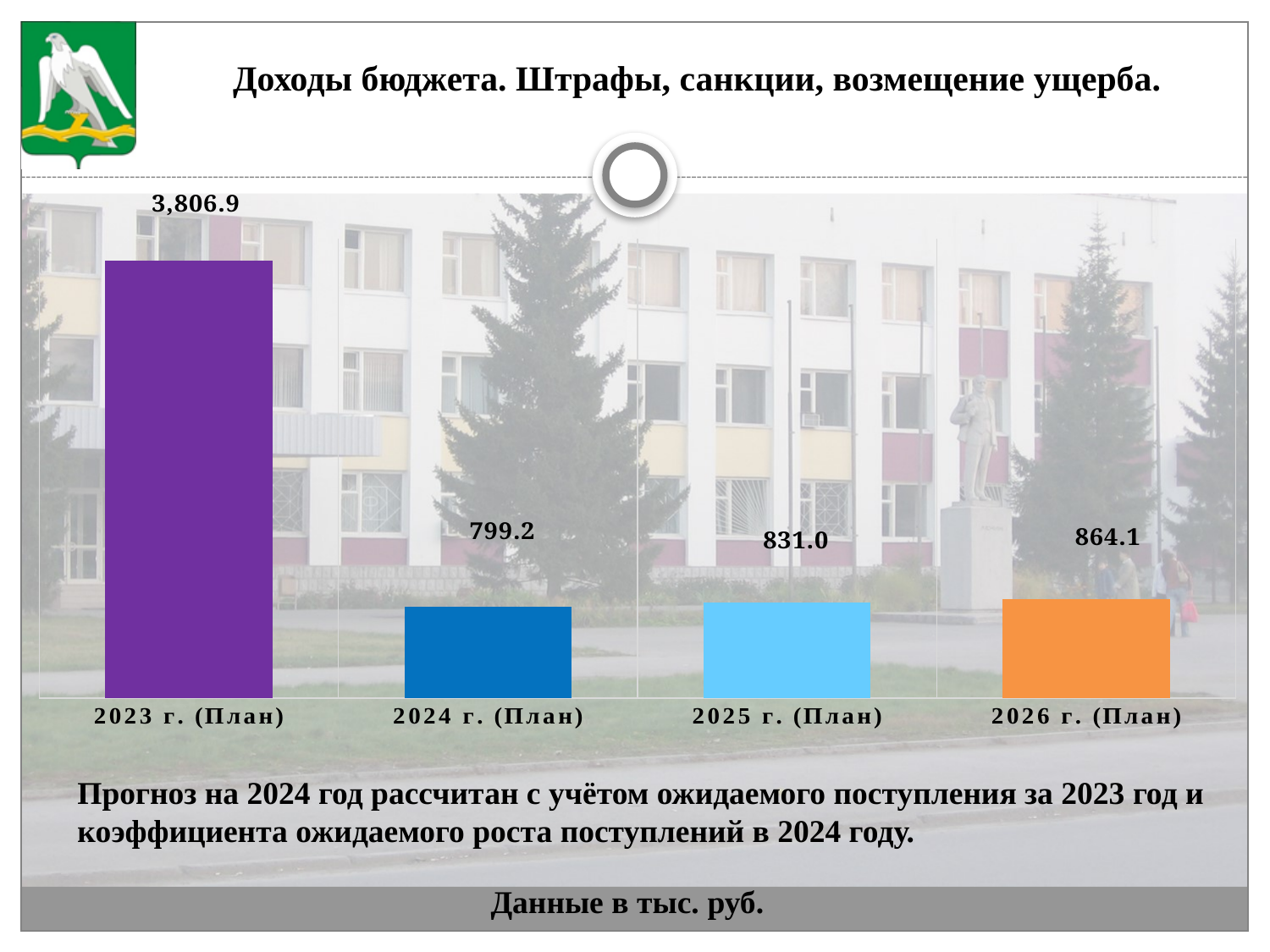
What is the value for 2024 г. (План)? 799.2 What is the value for 2025 г. (План)? 831.0 How many categories are shown in the chart? 4 What is the value for 2023 г. (План)? 3,806.9 What is the value for 2026 г. (План)? 864.1 What is the difference between the values for 2023 г. (План) and 2024 г. (План)? 3,007.7 What is the difference between the values for 2026 г. (План) and 2025 г. (План)? 33.1 Which is larger, the value for 2025 г. (План) or the value for 2024 г. (План)? 2025 г. (План) Do the values rise or fall from 2024 г. (План) to 2026 г. (План)? Rise Which category has the lowest value? 2024 г. (План) Which category has the highest value? 2023 г. (План) What kind of chart is shown on the slide? Bar chart